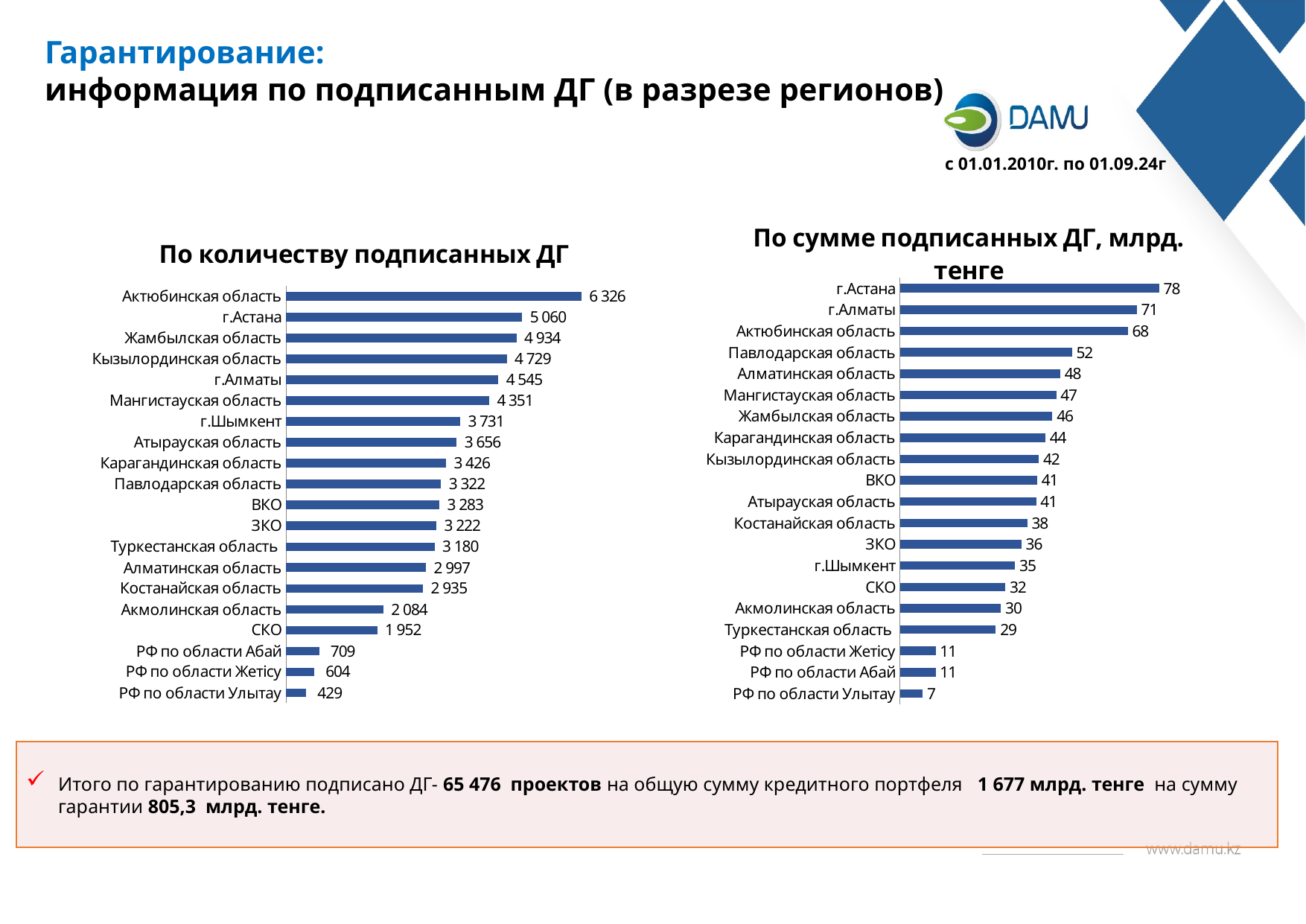
In the chart 'По сумме подписанных ДГ, млрд. тенге', what is the value for СКО? 32 In the chart 'По количеству подписанных ДГ', which category has the lowest value? РФ по области Улытау In the chart 'По количеству подписанных ДГ', what is the value for Жамбылская область? 4 934 In the chart 'По количеству подписанных ДГ', which region has the highest value? Актюбинская область In the chart 'По сумме подписанных ДГ, млрд. тенге', which is larger: Карагандинская область or Костанайская область? Карагандинская область In the chart 'По сумме подписанных ДГ, млрд. тенге', what is the value for Павлодарская область? 52 In the chart 'По сумме подписанных ДГ, млрд. тенге', which category has the lowest value? РФ по области Улытау In the chart 'По количеству подписанных ДГ', what is the difference between г.Астана and г.Алматы? 515 In the chart 'По сумме подписанных ДГ, млрд. тенге', which category has the highest value? г.Астана What type of chart is 'По количеству подписанных ДГ'? Bar chart In the chart 'По количеству подписанных ДГ', how many categories are shown? 20 In the chart 'По сумме подписанных ДГ, млрд. тенге', what is the difference between г.Астана and Актюбинская область? 10